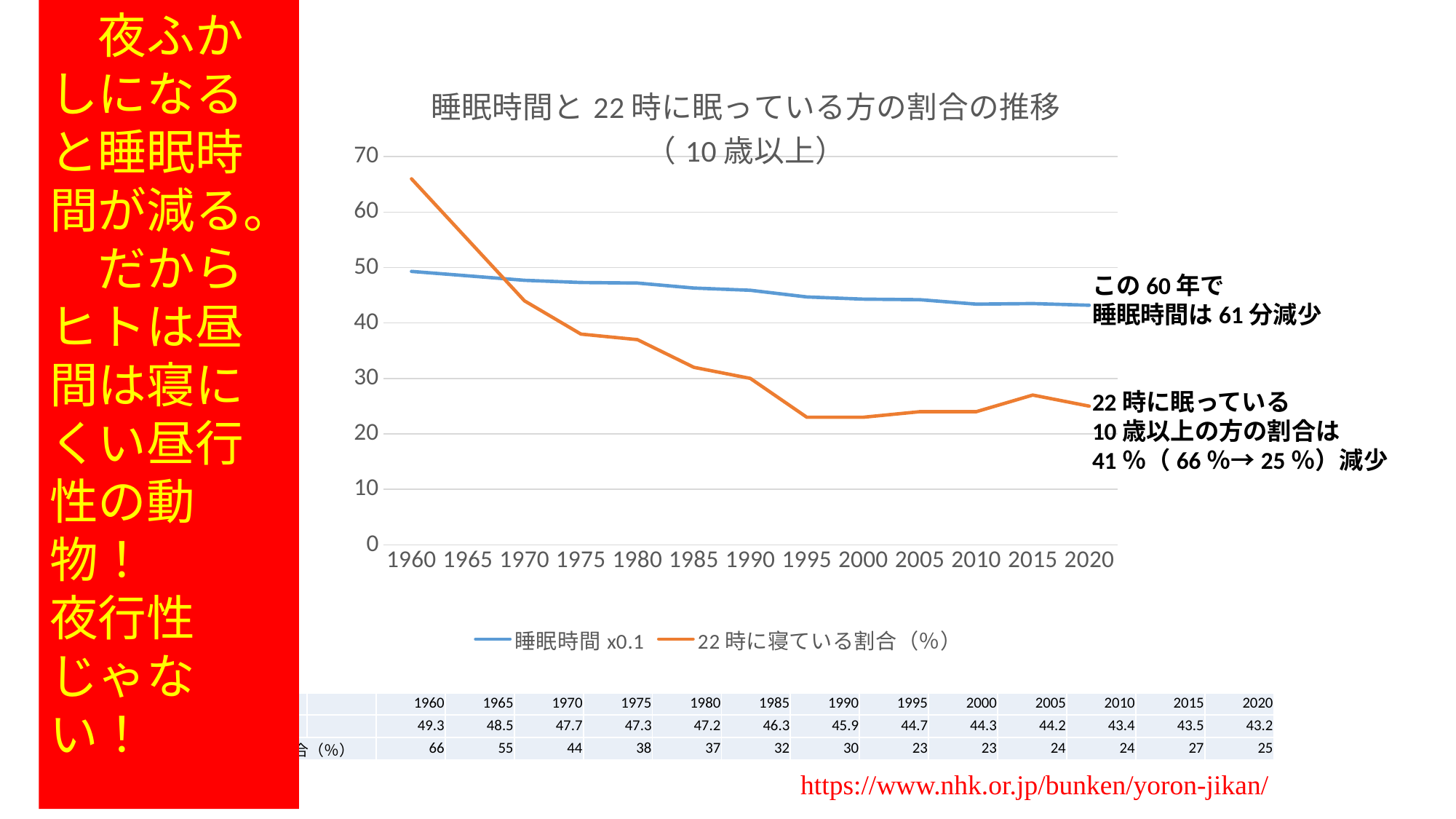
How many years are plotted along the x axis? 13 What is the value of 睡眠時間 x0.1 in 2020? 43.2 Does 22時に寝ている割合（%） generally rise or fall from 1960 to 2020? fall What is the value of 22時に寝ている割合（%） in 1960? 66 What kind of chart is shown on the slide? line chart What colour is the line for 22時に寝ている割合（%）? orange What is the difference between the 22時に寝ている割合（%） values in 1960 and 2020? 41 In which year is 22時に寝ている割合（%） highest? 1960 What is the value of 22時に寝ている割合（%） in 1990? 30 In which year is 睡眠時間 x0.1 lowest? 2020 Which is larger in 1980: 睡眠時間 x0.1 or 22時に寝ている割合（%）? 睡眠時間 x0.1 How many series does the legend list? 2